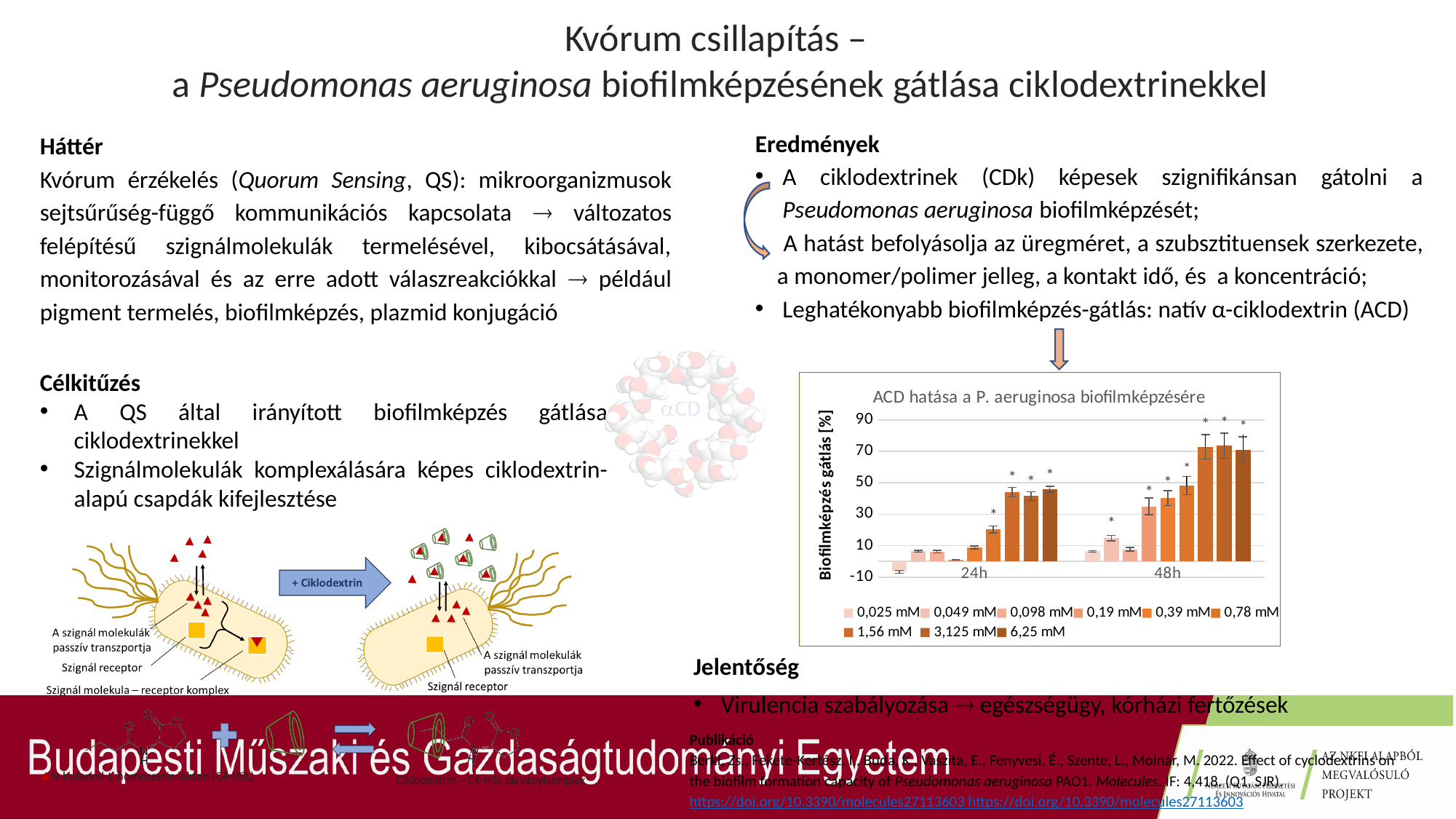
What kind of chart is shown on the slide? bar chart What is the label of the vertical axis of the chart? Biofilmképzés gátlás [%] Is the value for 0,78 mM at 48h greater or less than 30? greater Which concentration has the lowest value at 24h? 0,025 mM What is the title of the chart? ACD hatása a P. aeruginosa biofilmképzésére Is the value for 1,56 mM at 24h greater or less than 30? greater How many categories (time points) are shown on the x axis of the chart? 2 Which is larger at 24h: the value for 0,19 mM or for 1,56 mM? 1,56 mM Is the value for 0,025 mM at 24h greater or less than 10? less How many series does the chart legend list? 9 Which is larger: the value for 6,25 mM at 24h or at 48h? 48h